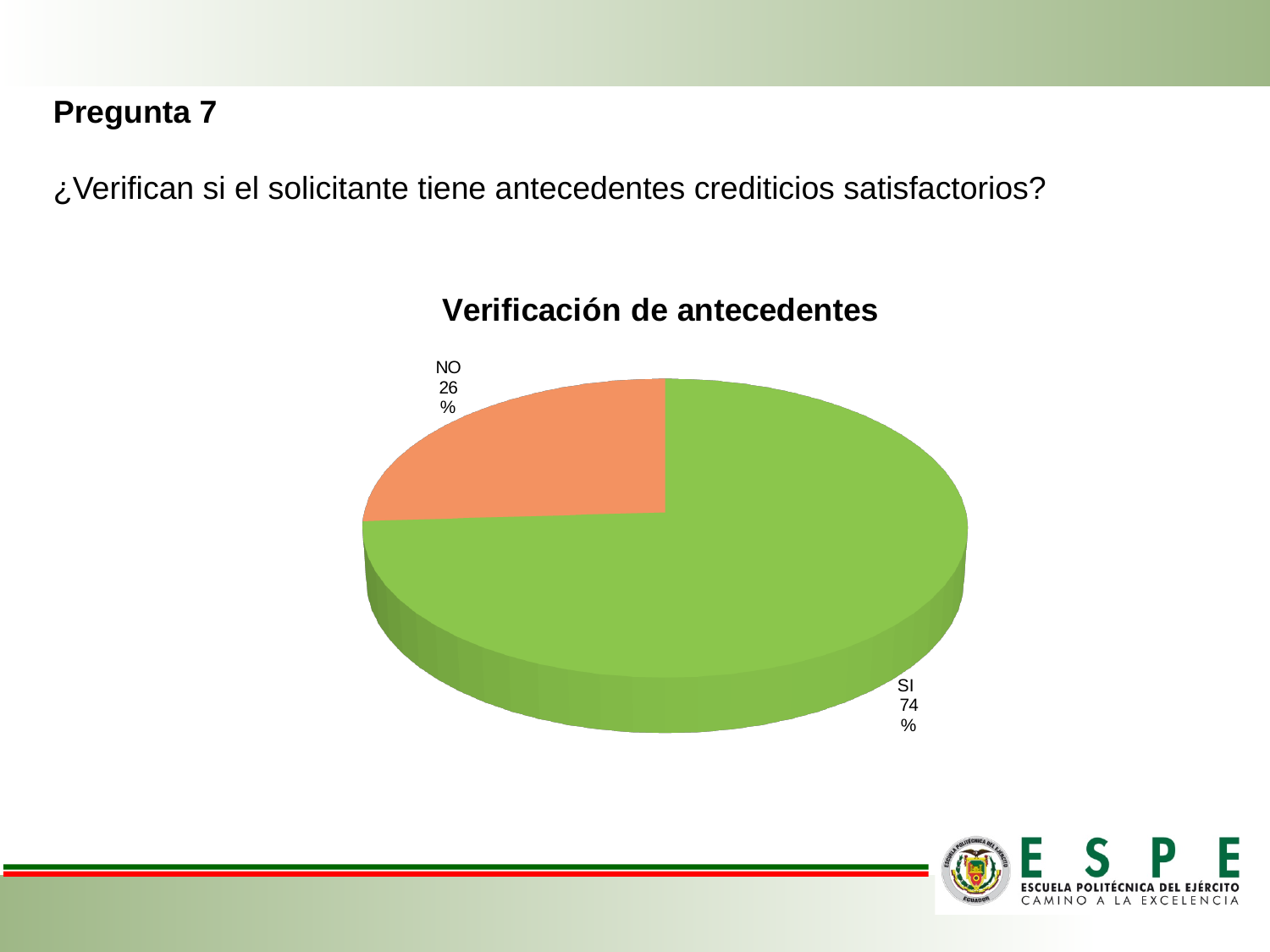
Which slice is the largest? SI What percentage is shown for the SI slice? 74% Which is larger, the SI slice or the NO slice? SI What is the difference in percentage points between the SI and NO slices? 48 What colour is the SI slice? Green What type of chart is shown on the slide? Pie chart What is the title of the chart? Verificación de antecedentes Which slice is the smallest? NO What share of the pie does the NO slice represent? 26% How many slices does the pie chart have? 2 What percentage is shown for the NO slice? 26%